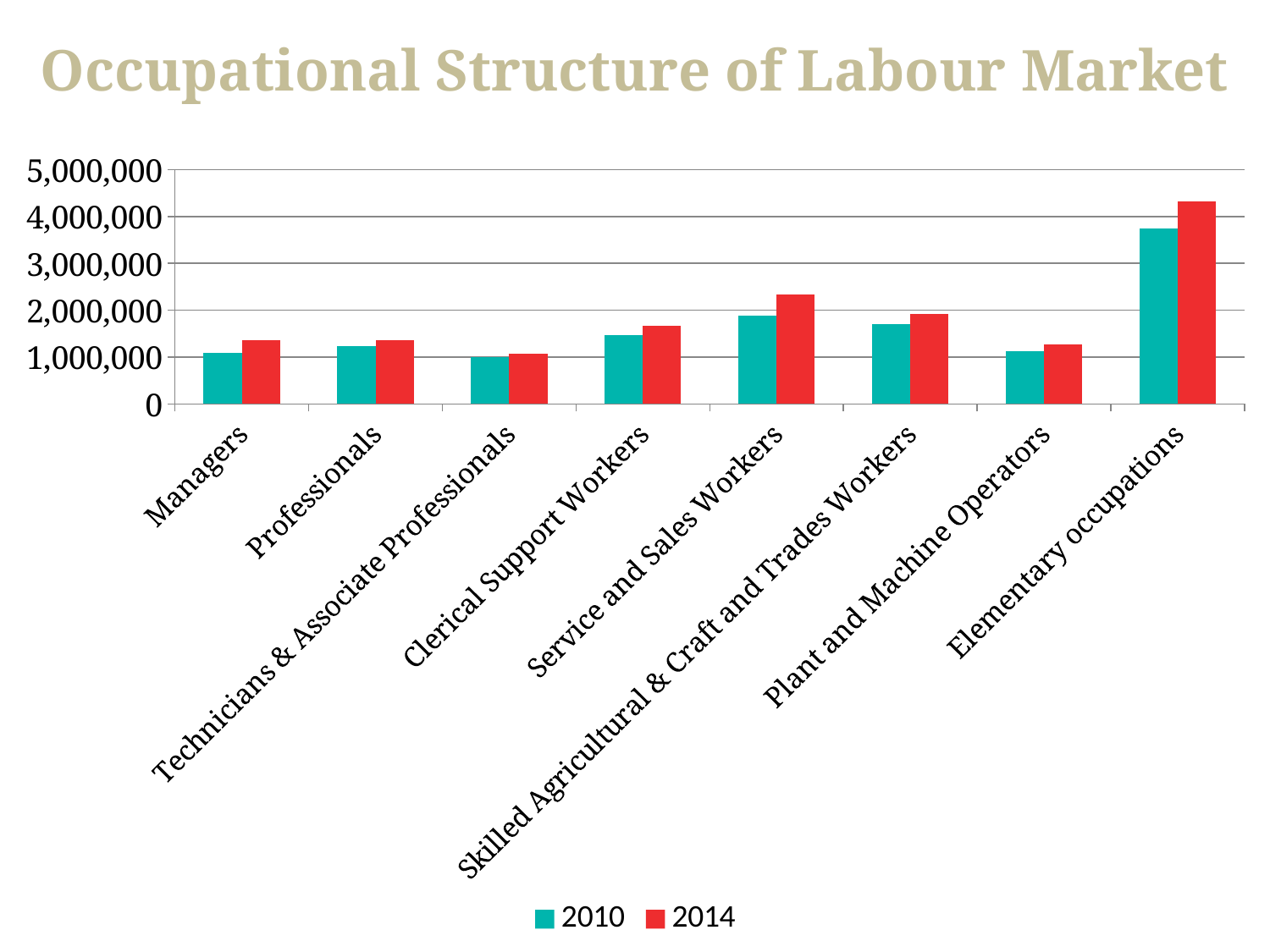
Is the 2010 value for Skilled Agricultural & Craft and Trades Workers greater or less than 2,000,000? less For 2010, which is larger: Clerical Support Workers or Managers? Clerical Support Workers Which occupational category has the highest value for 2014? Elementary occupations For 2014, which is larger: Service and Sales Workers or Skilled Agricultural & Craft and Trades Workers? Service and Sales Workers Is the 2014 value for Service and Sales Workers greater or less than 2,000,000? greater What is the title of the chart? Occupational Structure of Labour Market Which occupational category has the lowest value for 2014? Technicians & Associate Professionals How many occupational categories are shown on the x axis? 8 Is the 2014 value for Elementary occupations greater or less than 4,000,000? greater How many series does the legend list? 2 What kind of chart is shown on the slide? Bar chart